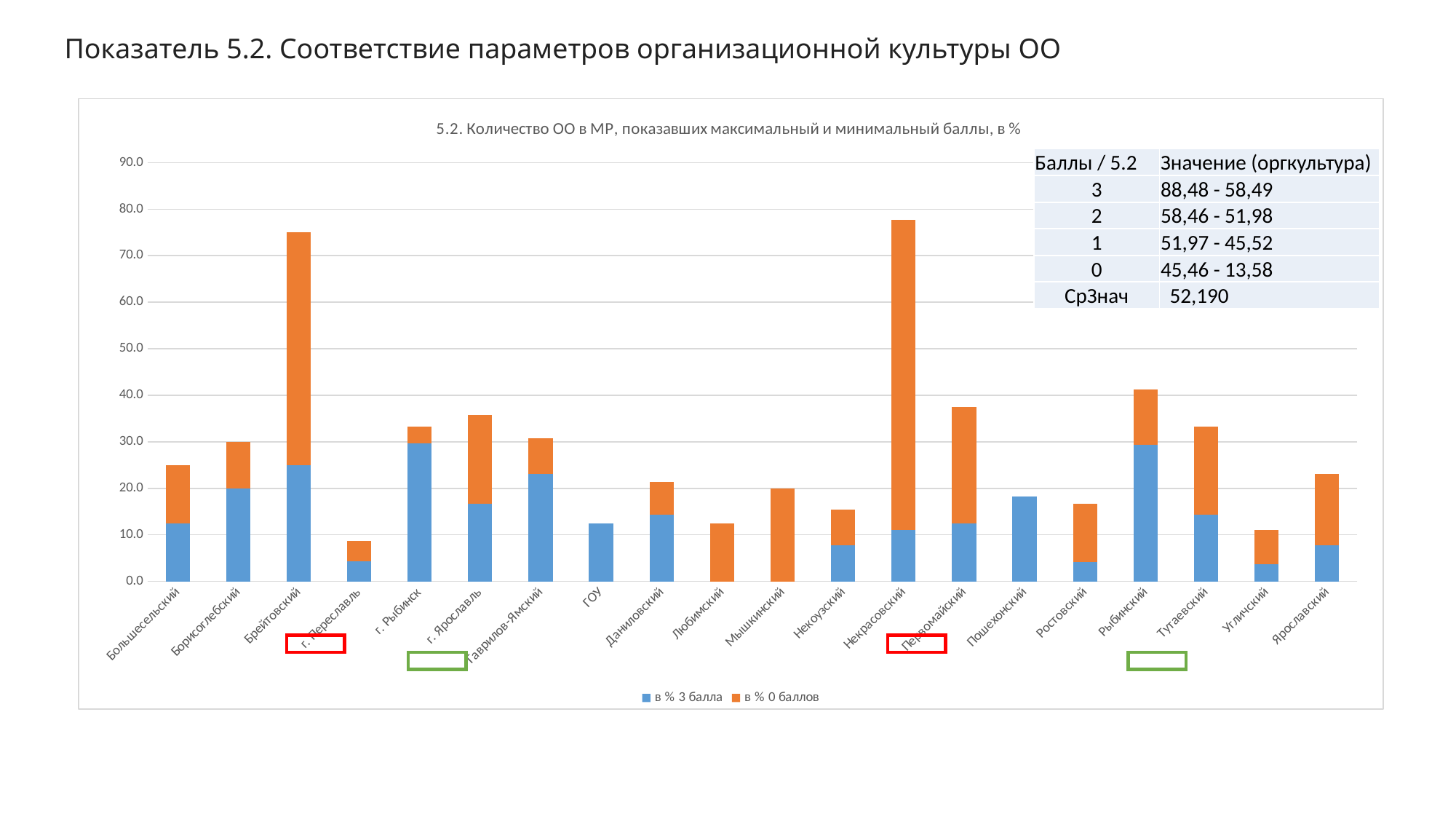
How many series does the chart legend list? 2 Is the total stacked value for Тутаевский greater or less than 30? greater Is the total stacked value for г. Переславль greater or less than 10? less Is the total stacked value for Брейтовский greater or less than 70? greater Which has the larger total stacked value, Брейтовский or Борисоглебский? Брейтовский How many categories are shown along the x axis of the chart? 20 Which series is shown in orange in the chart? в % 0 баллов What is the title of the chart? 5.2. Количество ОО в МР, показавших максимальный и минимальный баллы, в % What kind of chart is shown on the slide? Stacked bar chart Which has the larger total stacked value, Любимский or Мышкинский? Мышкинский